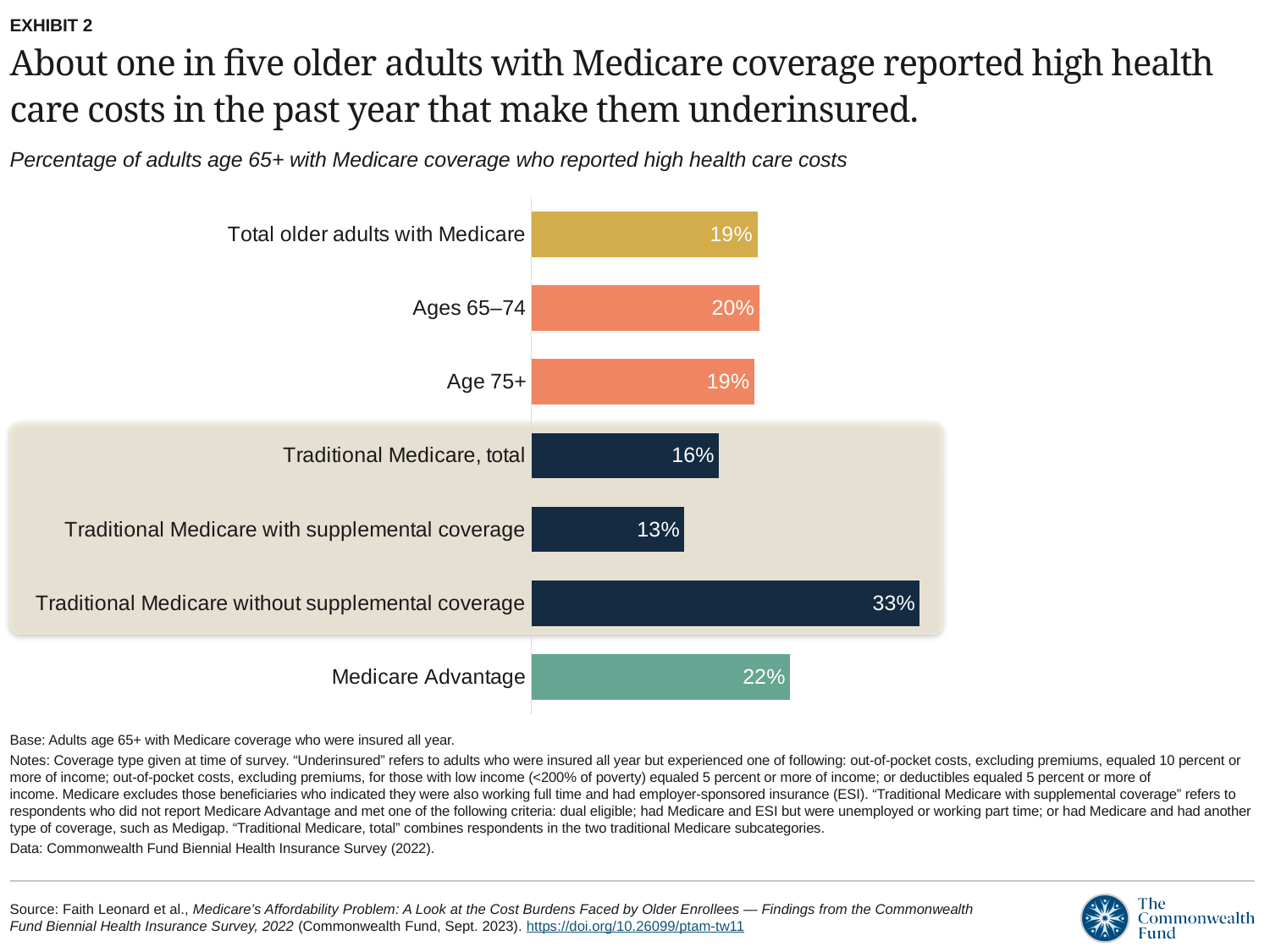
Which category has the lowest percentage? Traditional Medicare with supplemental coverage Which is larger, the value for Ages 65–74 or the value for Traditional Medicare, total? Ages 65–74 What is the value for Medicare Advantage? 22% What is the value for Traditional Medicare without supplemental coverage? 33% What is the value for Traditional Medicare with supplemental coverage? 13% Which category has the highest percentage? Traditional Medicare without supplemental coverage What is the difference between Medicare Advantage and Traditional Medicare, total? 6 percentage points Which categories are highlighted with a shaded background box? The three Traditional Medicare categories What percentage of total older adults with Medicare reported high health care costs? 19% What is the difference between Traditional Medicare without supplemental coverage and Traditional Medicare with supplemental coverage? 20 percentage points What kind of chart is shown on the slide? Bar chart How many categories are shown in the chart? 7